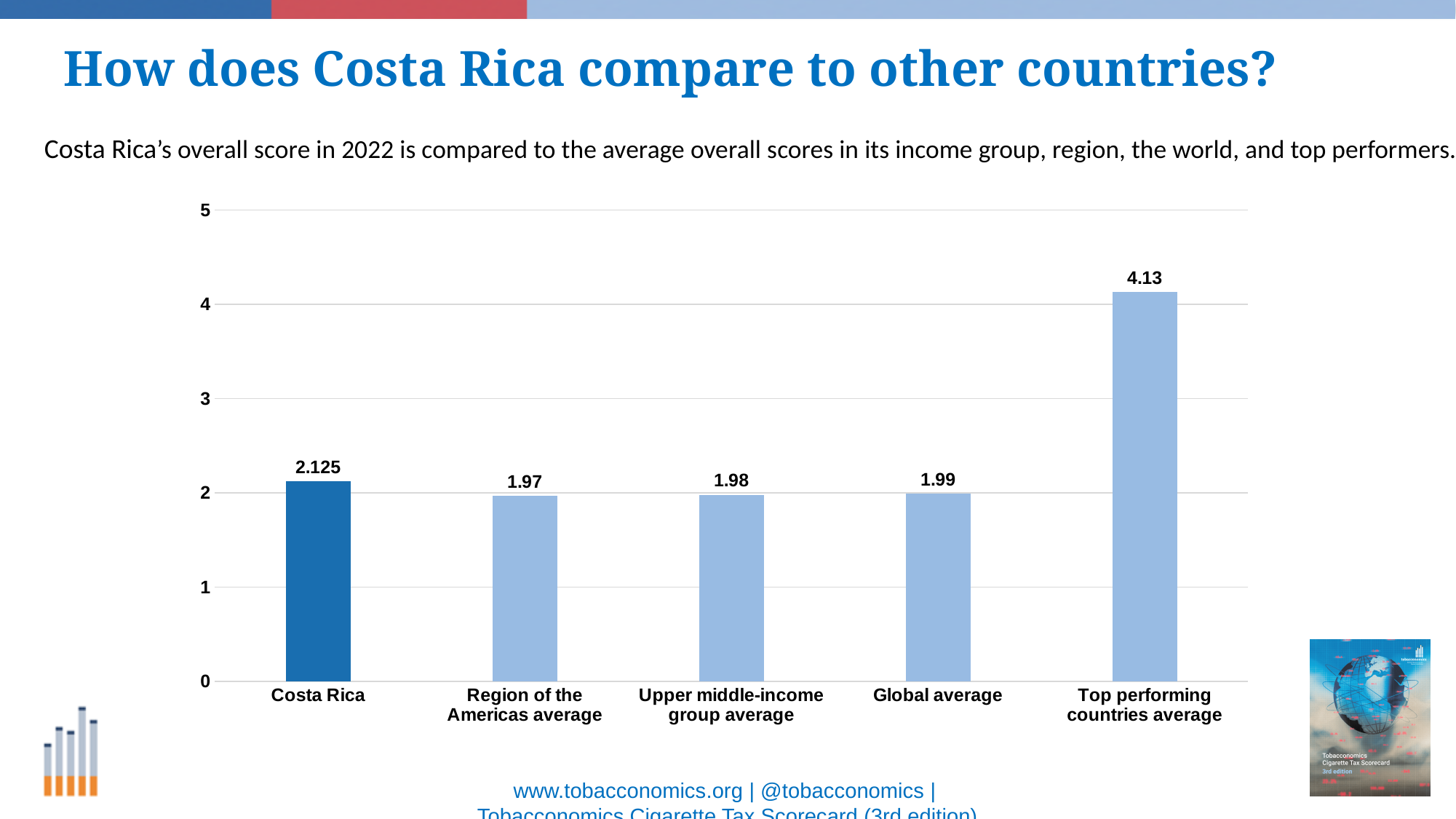
What is the value for Global average? 1.99 What is the value for Region of the Americas average? 1.97 What is the value for Upper middle-income group average? 1.98 Which is larger, the value for Costa Rica or the value for Global average? Costa Rica How many categories are shown on the chart? 5 Which category has the highest value? Top performing countries average What is the difference between the Top performing countries average and Costa Rica? 2.005 What kind of chart is shown on the slide? Bar chart What is the value for Top performing countries average? 4.13 Is the value for Top performing countries average greater or less than 4? greater What is the difference between Costa Rica and the Global average? 0.135 What is the value for Costa Rica? 2.125